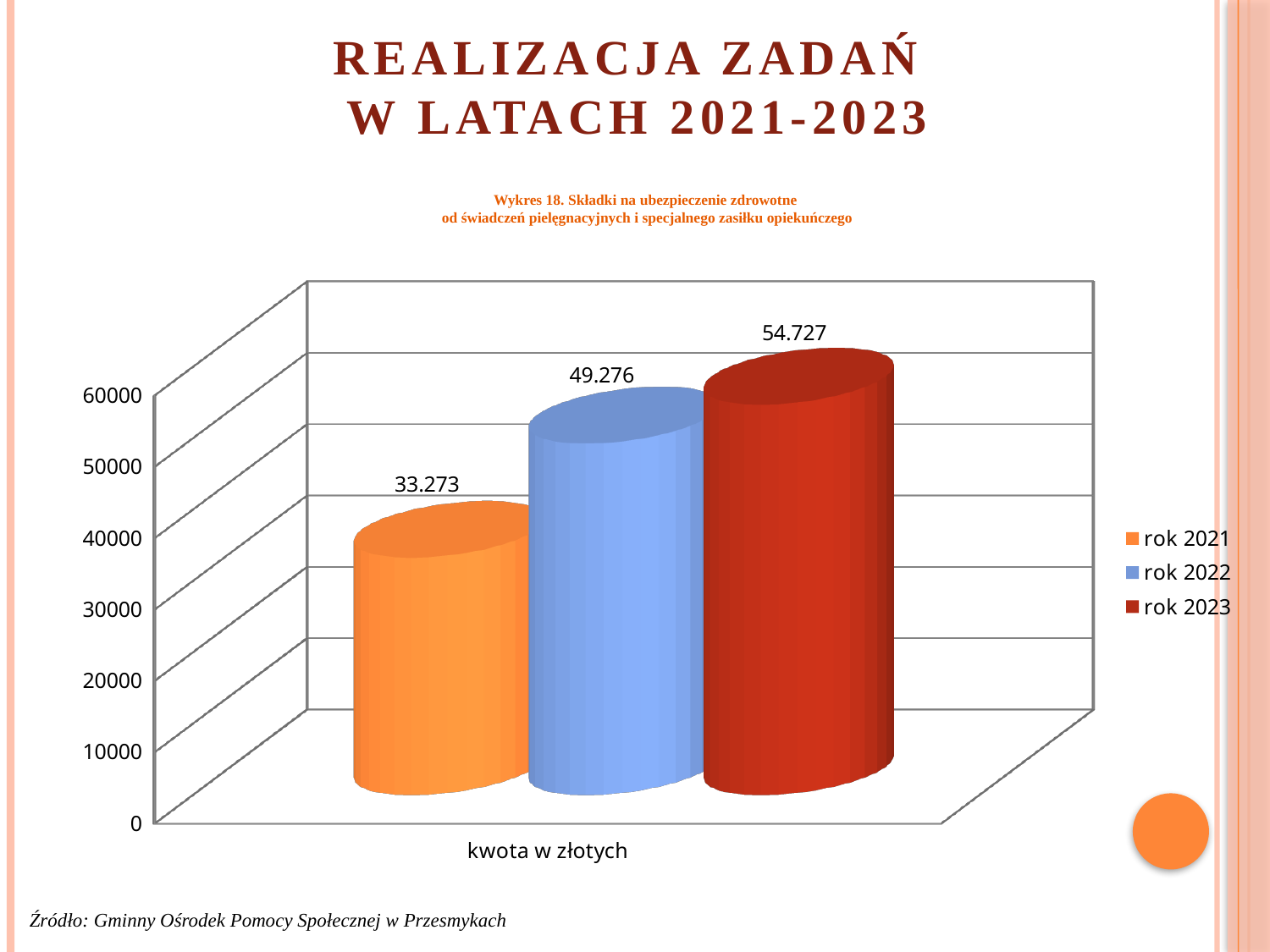
What is the value for rok 2022? 49.276 What kind of chart is shown on the slide? bar chart What is the label on the horizontal axis of the chart? kwota w złotych What is the difference between the values for rok 2023 and rok 2021? 21.454 Which year has the highest value? rok 2023 How many series does the legend list? 3 What is the difference between the values for rok 2022 and rok 2021? 16.003 Which is larger, the value for rok 2022 or rok 2023? rok 2023 What is the value for rok 2021? 33.273 Which year has the lowest value? rok 2021 What is the value for rok 2023? 54.727 Do the values rise or fall from rok 2021 to rok 2023? rise